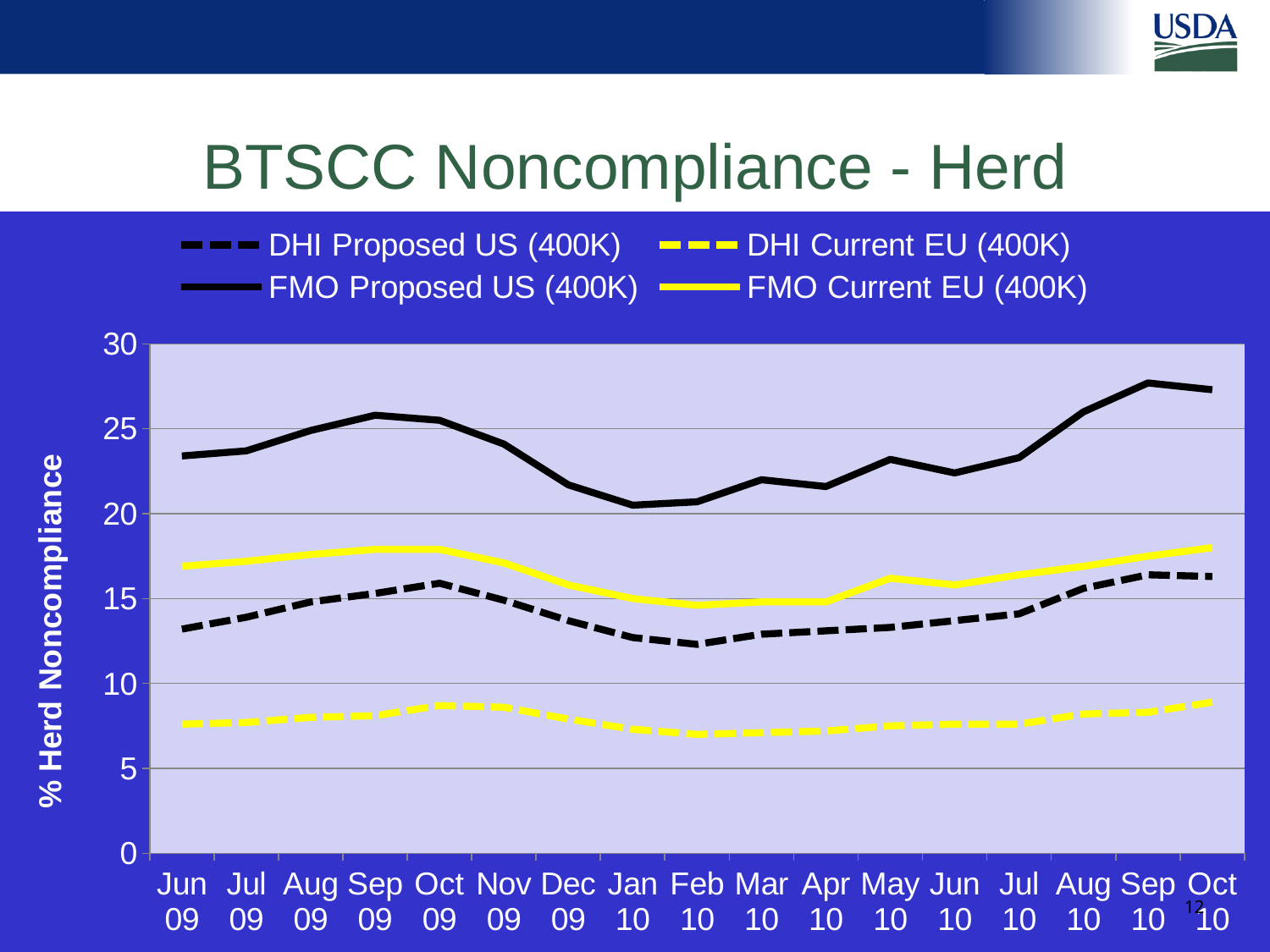
Which series has the highest values across the whole period? FMO Proposed US (400K) Is the value for DHI Current EU (400K) in Feb 10 greater or less than 10? less Is the value for FMO Proposed US (400K) in Sep 10 greater or less than 25? greater In Jun 09, which is larger: FMO Proposed US (400K) or DHI Current EU (400K)? FMO Proposed US (400K) Is the value for DHI Proposed US (400K) in Feb 10 greater or less than 15? less Which series has the lowest values across the whole period? DHI Current EU (400K) Does the FMO Proposed US (400K) line rise or fall from Feb 10 to Sep 10? rise What is the label on the y axis? % Herd Noncompliance How many months are plotted along the x axis? 17 What kind of chart is shown on the slide? line chart How many series does the legend list? 4